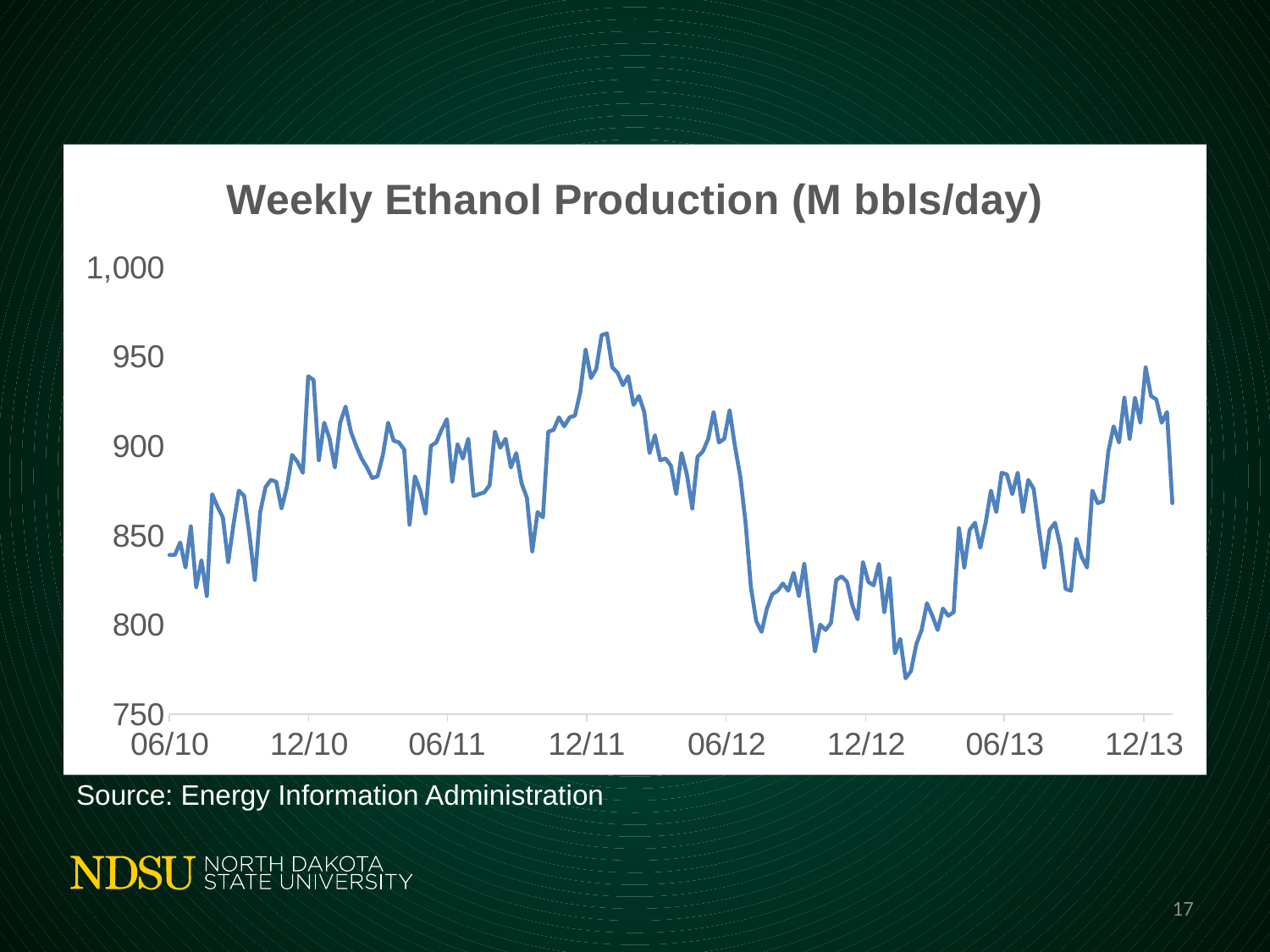
Does weekly ethanol production generally rise or fall between 12/12 and 12/13? rise Is the lowest point on the line greater or less than 800? less What is the title of the chart? Weekly Ethanol Production (M bbls/day) Does weekly ethanol production generally rise or fall between 06/12 and 12/12? fall Is the highest point on the line greater or less than 950? greater What kind of chart is shown on the slide? line chart Is the value at the 12/11 tick greater or less than 900? greater What source is cited below the chart? Energy Information Administration How many date labels are shown on the x axis? 8